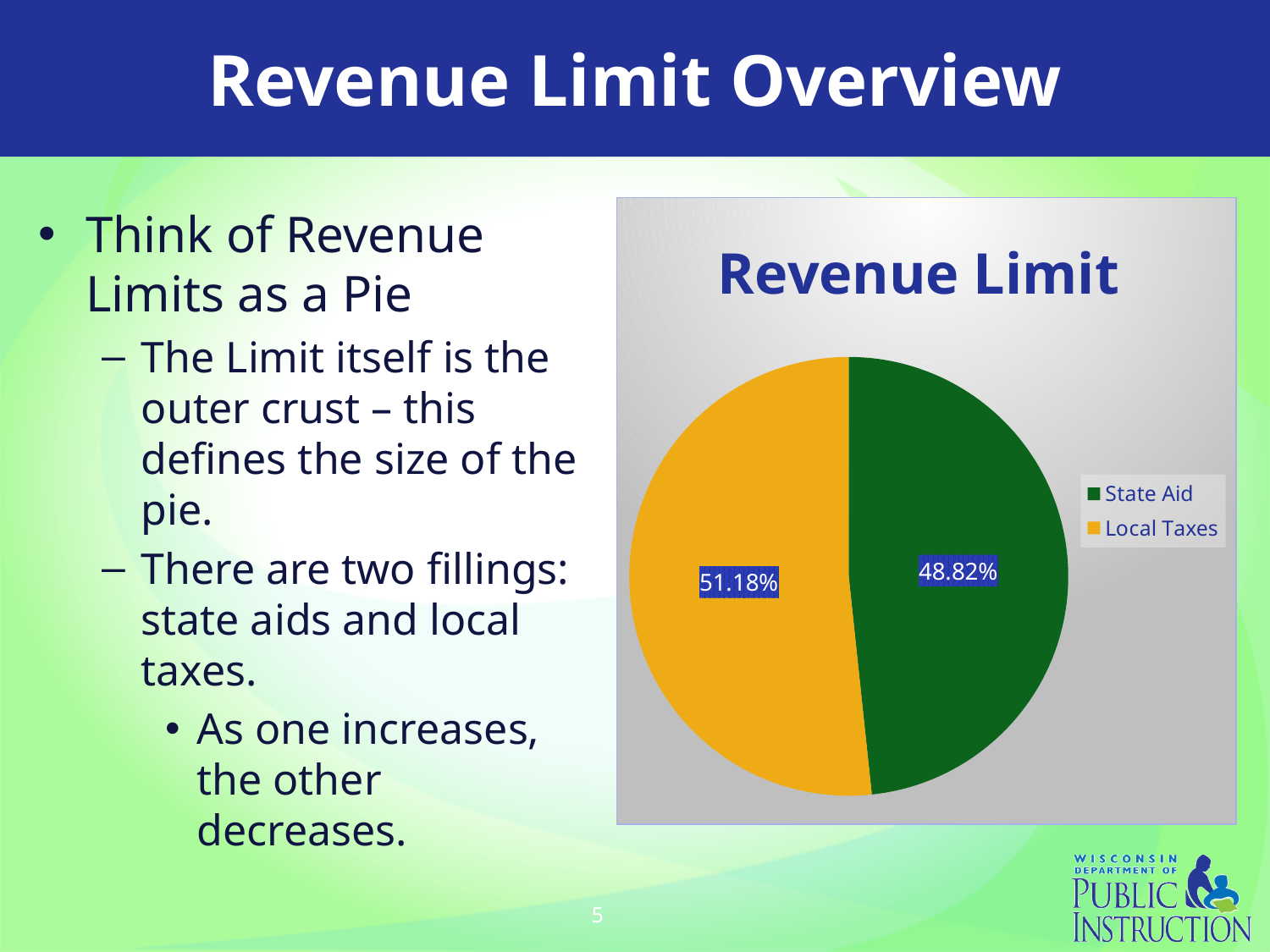
What type of chart is shown on the slide? pie chart Which is larger, State Aid or Local Taxes? Local Taxes What percentage of the pie is Local Taxes? 51.18% What percentage of the pie is State Aid? 48.82% What is the title of the chart? Revenue Limit Is the share for State Aid greater or less than 50%? less How many slices does the pie chart have? 2 Which slice is the smallest? State Aid What is the difference between the Local Taxes share and the State Aid share? 2.36% What colour is the State Aid slice? green Which slice is the largest? Local Taxes How many entries does the legend list? 2